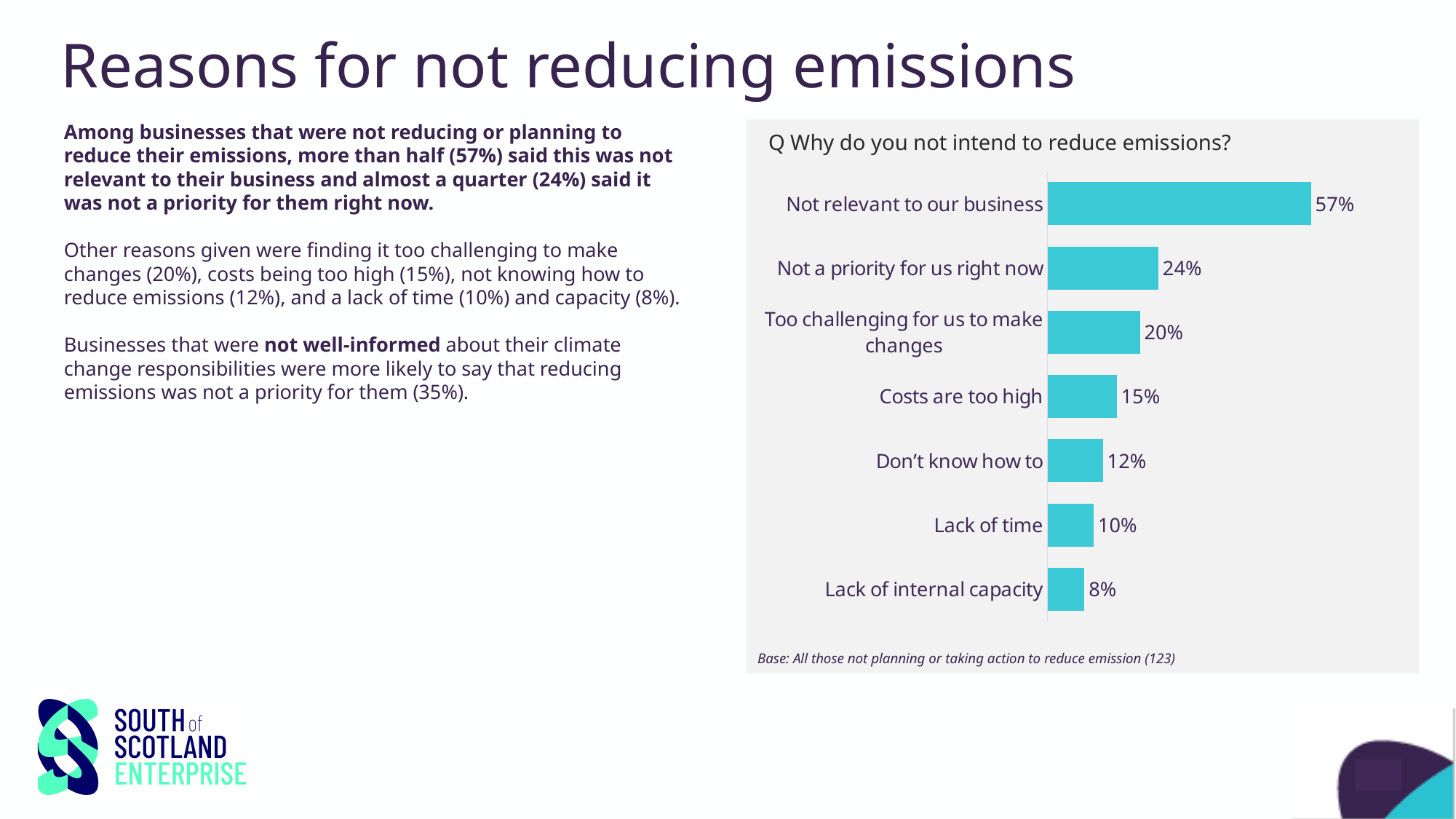
Which reason has the highest percentage? Not relevant to our business How many reasons are shown in the chart? 7 Which is larger: 'Costs are too high' or 'Lack of time'? Costs are too high What is the difference between 'Too challenging for us to make changes' and 'Don't know how to'? 8 percentage points What is the difference between 'Not relevant to our business' and 'Not a priority for us right now'? 33 percentage points What question is shown as the chart's title? Q Why do you not intend to reduce emissions? What is the base size stated below the chart? 123 Which reason has the lowest percentage? Lack of internal capacity What percentage cited 'Lack of time' as a reason? 10% What type of chart is shown on the slide? Bar chart What is the value for 'Costs are too high'? 15% What percentage of respondents said 'Not relevant to our business'? 57%